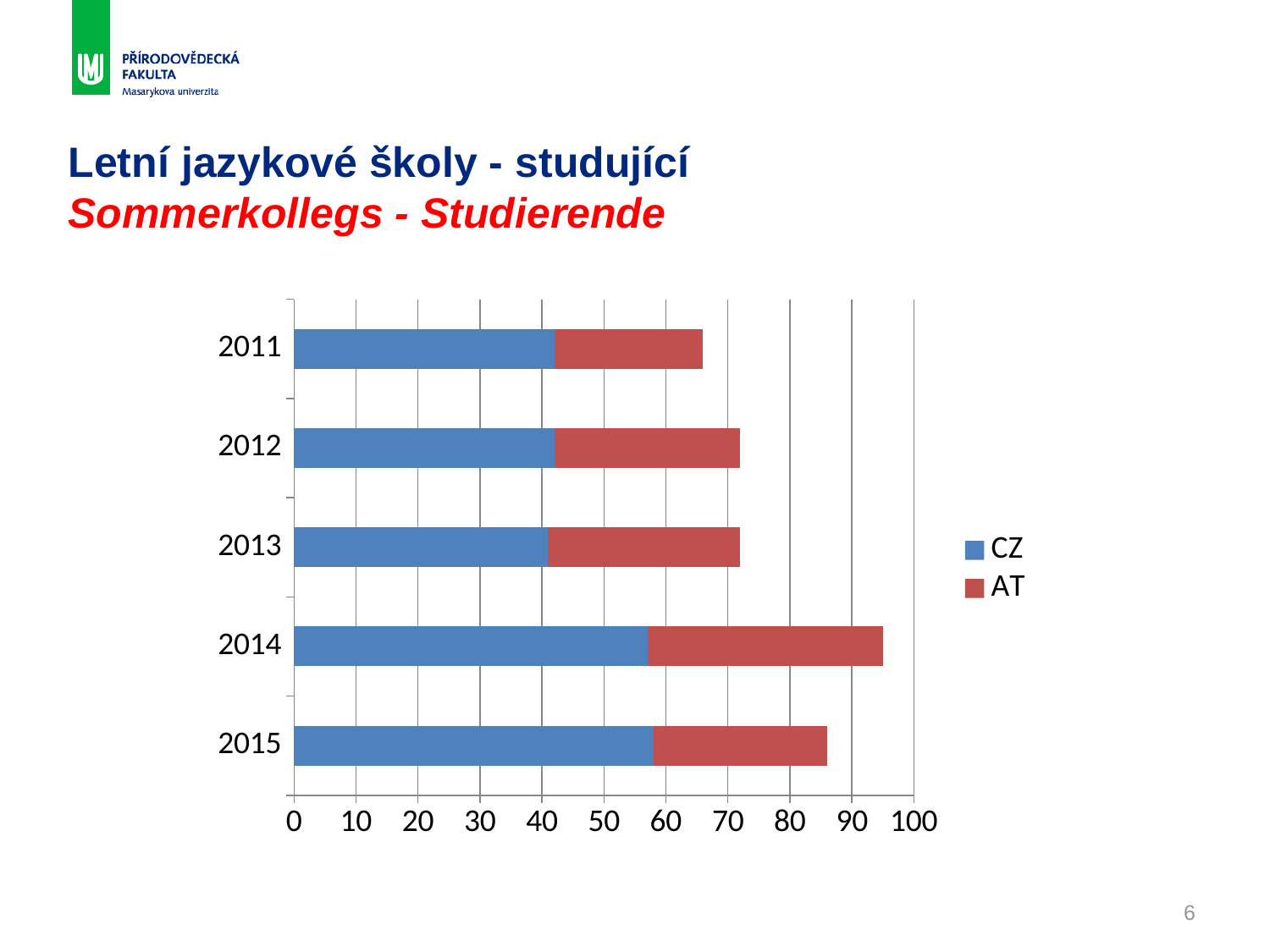
Which colour represents the AT series in the legend? red Is the CZ value for 2015 greater or less than 50? greater How many years are shown on the chart? 5 Which year has the lowest total bar? 2011 Is the total value for 2011 greater or less than 70? less Is the total value for 2014 greater or less than 90? greater Which has the larger CZ value, 2011 or 2014? 2014 Which year has the highest total bar? 2014 How many series does the legend list? 2 What kind of chart is shown on the slide? stacked bar chart Which has the larger total bar, 2014 or 2015? 2014